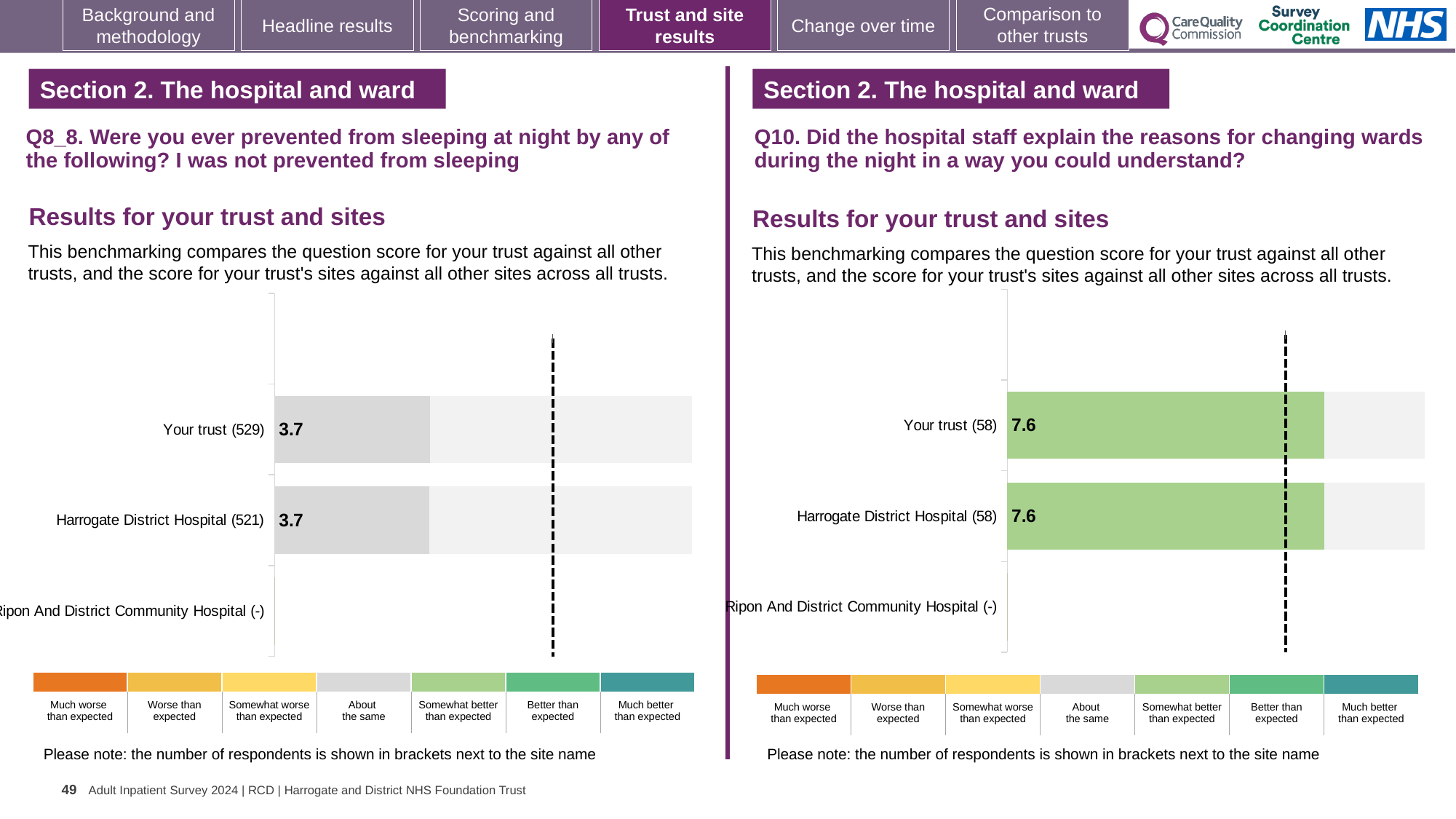
In the right chart (Q10), what is the difference between the score for Your trust and the score for Harrogate District Hospital? 0 How many categories (rows) are listed on the y axis of the right chart (Q10)? 3 In the left chart (Q8_8), what is the score for Your trust (529)? 3.7 How many categories (rows) are listed on the y axis of the left chart (Q8_8)? 3 What kind of chart is the right chart (Q10)? Bar chart In the left chart (Q8_8), what is the score for Harrogate District Hospital (521)? 3.7 In the left chart (Q8_8), how many respondents are shown in brackets for Your trust? 529 In the right chart (Q10), which benchmark category does the green colour of the bars correspond to in the legend? Somewhat better than expected In the left chart (Q8_8), what is the difference between the score for Your trust and the score for Harrogate District Hospital? 0 In the right chart (Q10), what is the score for Your trust (58)? 7.6 In the left chart (Q8_8), which site has no score shown (marked with a dash)? Ripon And District Community Hospital In the right chart (Q10), what is the score for Harrogate District Hospital (58)? 7.6